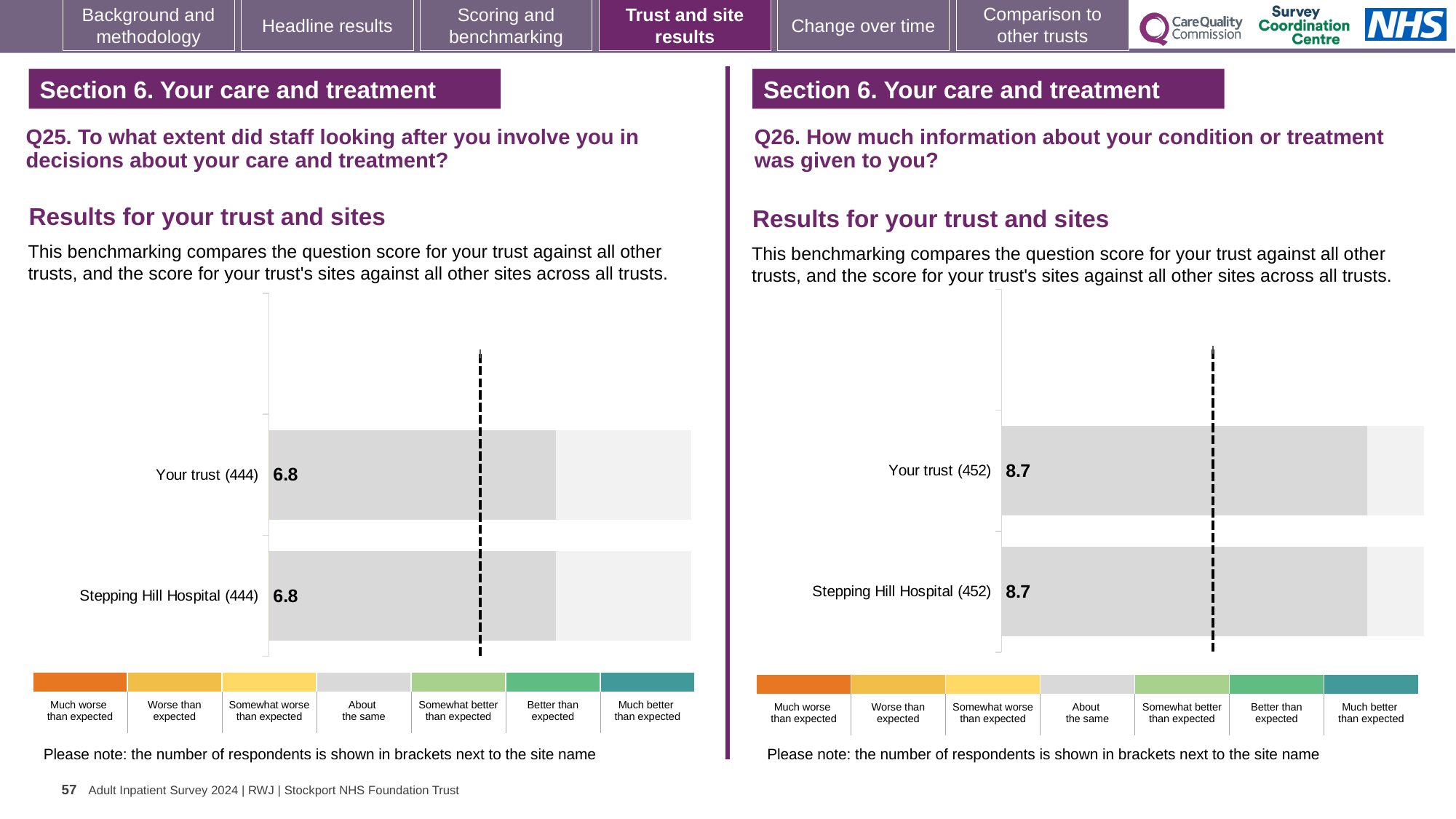
What kind of chart is used for the Q25 results on the left? Bar chart In the Q25 chart on the left, how many bars are plotted? 2 Which is larger: the Your trust score in the Q26 chart on the right or the Your trust score in the Q25 chart on the left? Q26 chart (8.7) In the Q25 chart on the left, what is the score for Stepping Hill Hospital? 6.8 In the Q26 chart on the right, what is the score for Stepping Hill Hospital? 8.7 In the Q25 chart on the left, what is the score for Your trust? 6.8 In the Q26 chart on the right, how many respondents are shown in brackets next to Stepping Hill Hospital? 452 In the Q25 chart on the left, how many respondents are shown in brackets next to Your trust? 444 In the Q26 chart on the right, what is the score for Your trust? 8.7 In the Q26 chart on the right, how many bars are plotted? 2 What is the difference between the Your trust score in the Q26 chart on the right and the Your trust score in the Q25 chart on the left? 1.9